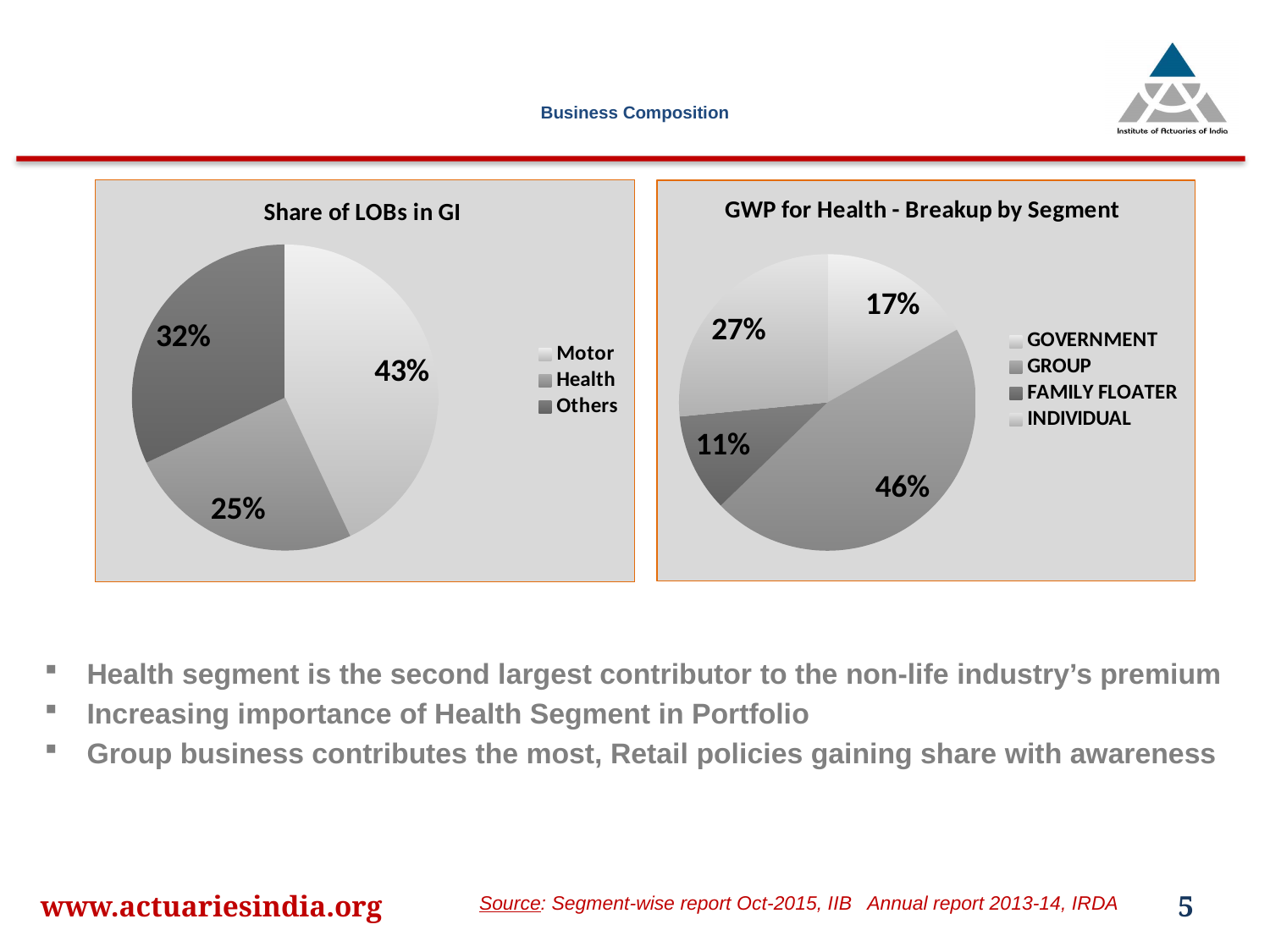
In the 'GWP for Health - Breakup by Segment' chart, what is the difference between the GROUP share and the INDIVIDUAL share? 19% In the 'GWP for Health - Breakup by Segment' chart, what share does FAMILY FLOATER have? 11% In the 'Share of LOBs in GI' chart, which line of business has the smallest share? Health In the 'GWP for Health - Breakup by Segment' chart, which is larger, INDIVIDUAL or GOVERNMENT? INDIVIDUAL In the 'Share of LOBs in GI' chart, how many categories does the legend list? 3 In the 'Share of LOBs in GI' chart, what share does Motor have? 43% What type of chart is the chart on the right of the slide? Pie chart In the 'Share of LOBs in GI' chart, what share does Health have? 25% In the 'Share of LOBs in GI' chart, what is the difference between the Motor share and the Others share? 11% In the 'GWP for Health - Breakup by Segment' chart, which segment has the smallest share? FAMILY FLOATER In the 'Share of LOBs in GI' chart, which line of business has the largest share? Motor In the 'GWP for Health - Breakup by Segment' chart, what share does GROUP have? 46%